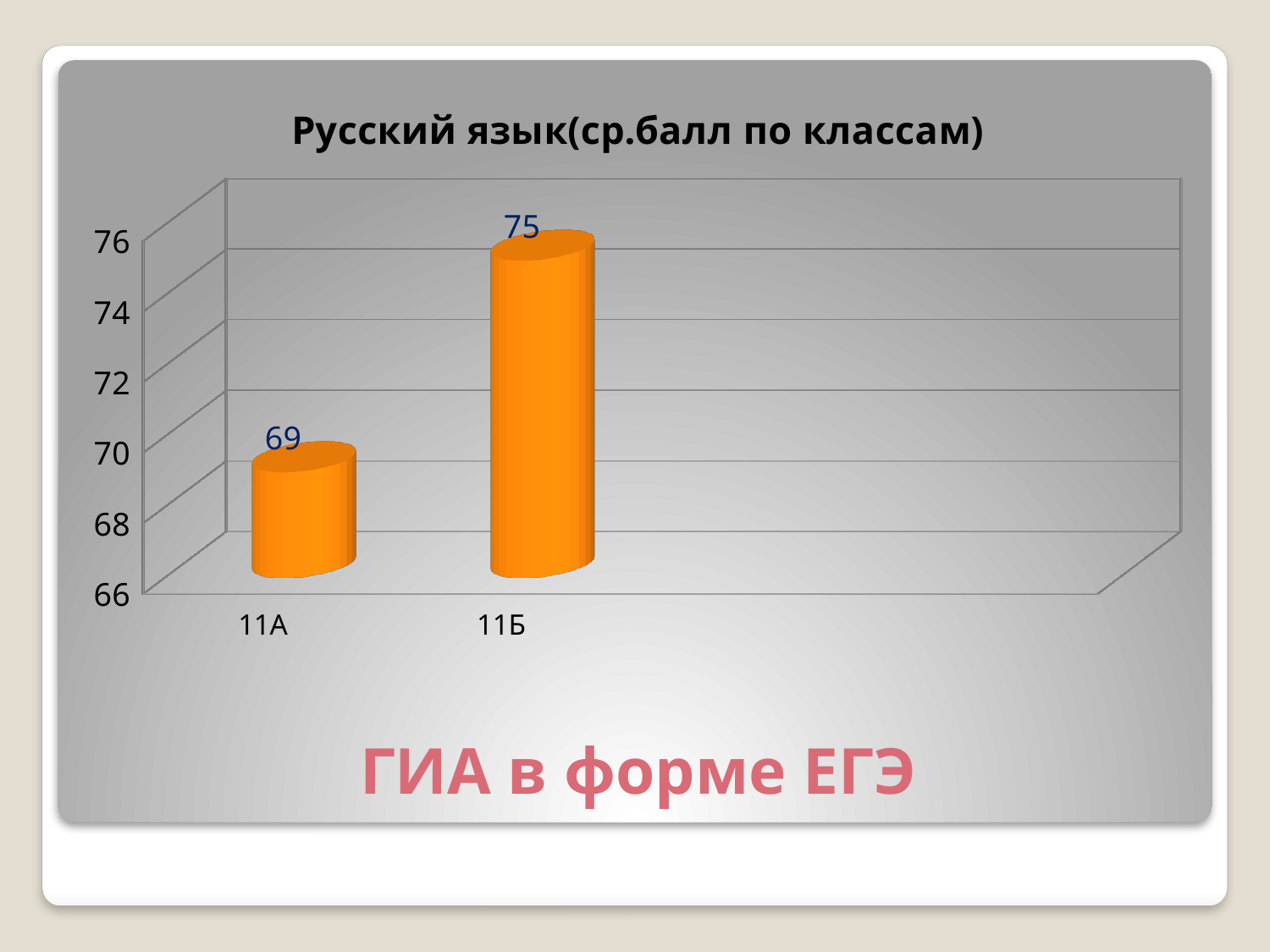
What colour are the bars in the chart? orange Which class has the highest average score? 11Б Is the value for 11Б greater or less than 72? greater What is the title of the chart? Русский язык(ср.балл по классам) What is the average score for class 11Б? 75 Is the value for 11А greater or less than 70? less Which class has the lowest average score? 11А What is the average score for class 11А? 69 What is the difference between the average scores of 11Б and 11А? 6 Which class has the larger average score, 11А or 11Б? 11Б What kind of chart is shown on the slide? bar chart How many classes are shown in the chart? 2